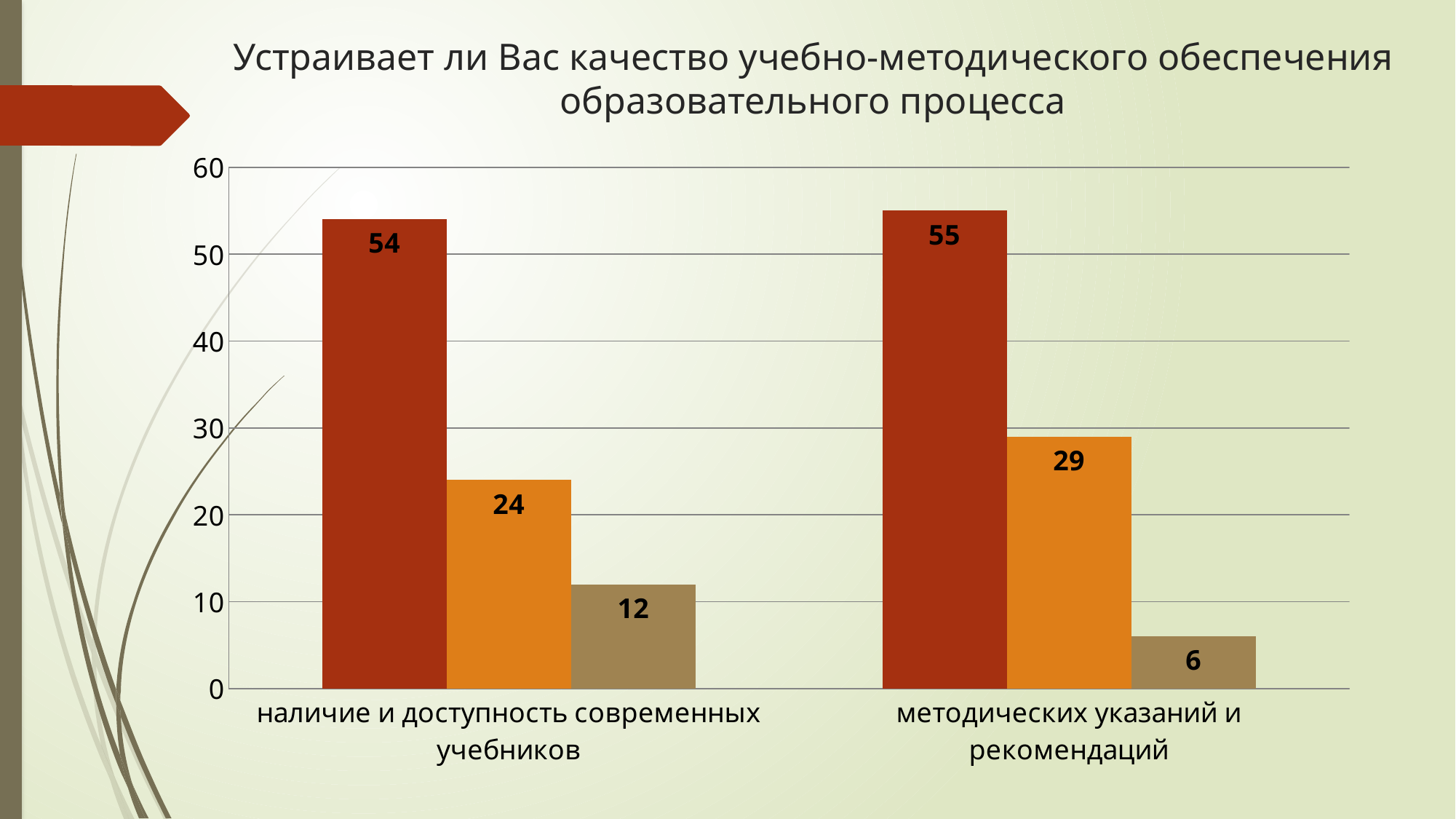
What is the value of the orange bar for "методических указаний и рекомендаций"? 29 What is the difference between the orange bars for "методических указаний и рекомендаций" and "наличие и доступность современных учебников"? 5 What is the difference between the dark red bar and the orange bar for "наличие и доступность современных учебников"? 30 What is the value of the brown bar for "методических указаний и рекомендаций"? 6 Which bar has the highest value on the chart? the dark red bar for "методических указаний и рекомендаций" (55) Which is larger: the brown bar for "наличие и доступность современных учебников" or the brown bar for "методических указаний и рекомендаций"? наличие и доступность современных учебников What is the value of the brown bar for "наличие и доступность современных учебников"? 12 What type of chart is shown on the slide? bar chart What is the title of the chart? Устраивает ли Вас качество учебно-методического обеспечения образовательного процесса Which bar has the lowest value on the chart? the brown bar for "методических указаний и рекомендаций" (6) How many categories are shown on the x axis? 2 What is the value of the dark red bar for "наличие и доступность современных учебников"? 54